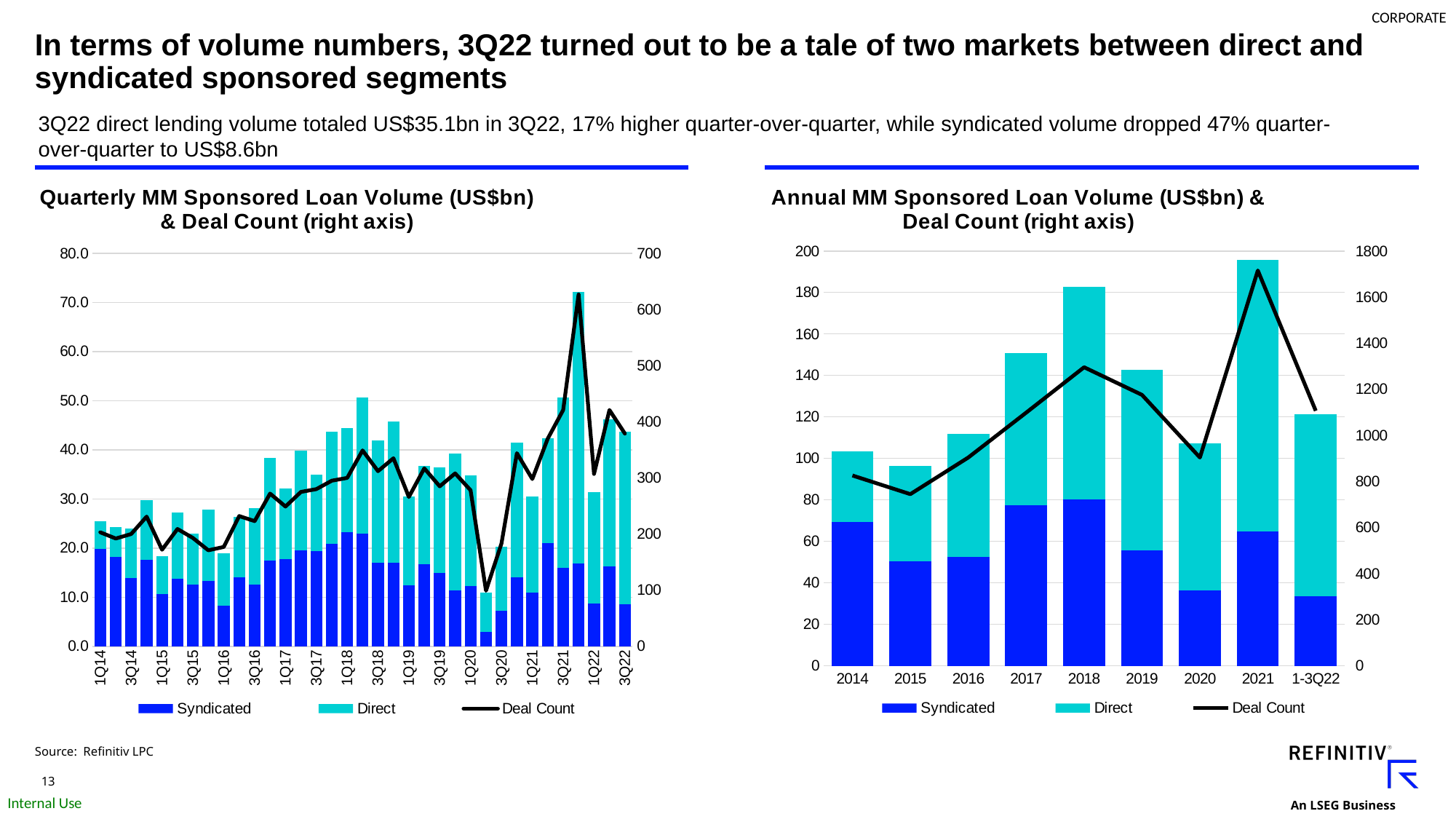
On the Annual MM Sponsored Loan Volume chart, which year has the tallest stacked bar? 2021 On the Annual MM Sponsored Loan Volume chart, how many series does the legend list? 3 On the Annual MM Sponsored Loan Volume chart, is the total stacked bar for 2020 greater or less than 120? less On the Annual MM Sponsored Loan Volume chart, in which year does the Deal Count line reach its highest point? 2021 On the Annual MM Sponsored Loan Volume chart, how many categories are shown on the x axis? 9 On the Annual MM Sponsored Loan Volume chart, is the total stacked bar for 2021 greater or less than 180? greater On the Annual MM Sponsored Loan Volume chart, which has the larger total stacked bar, 2018 or 2019? 2018 On the Annual MM Sponsored Loan Volume chart, which year has the shortest stacked bar? 2015 On the Annual MM Sponsored Loan Volume chart, is the Deal Count for 2015 greater or less than 800? less What kind of chart is the Quarterly MM Sponsored Loan Volume chart? Stacked bar chart with a line On the Quarterly MM Sponsored Loan Volume chart, which quarter has the tallest stacked bar? 4Q21